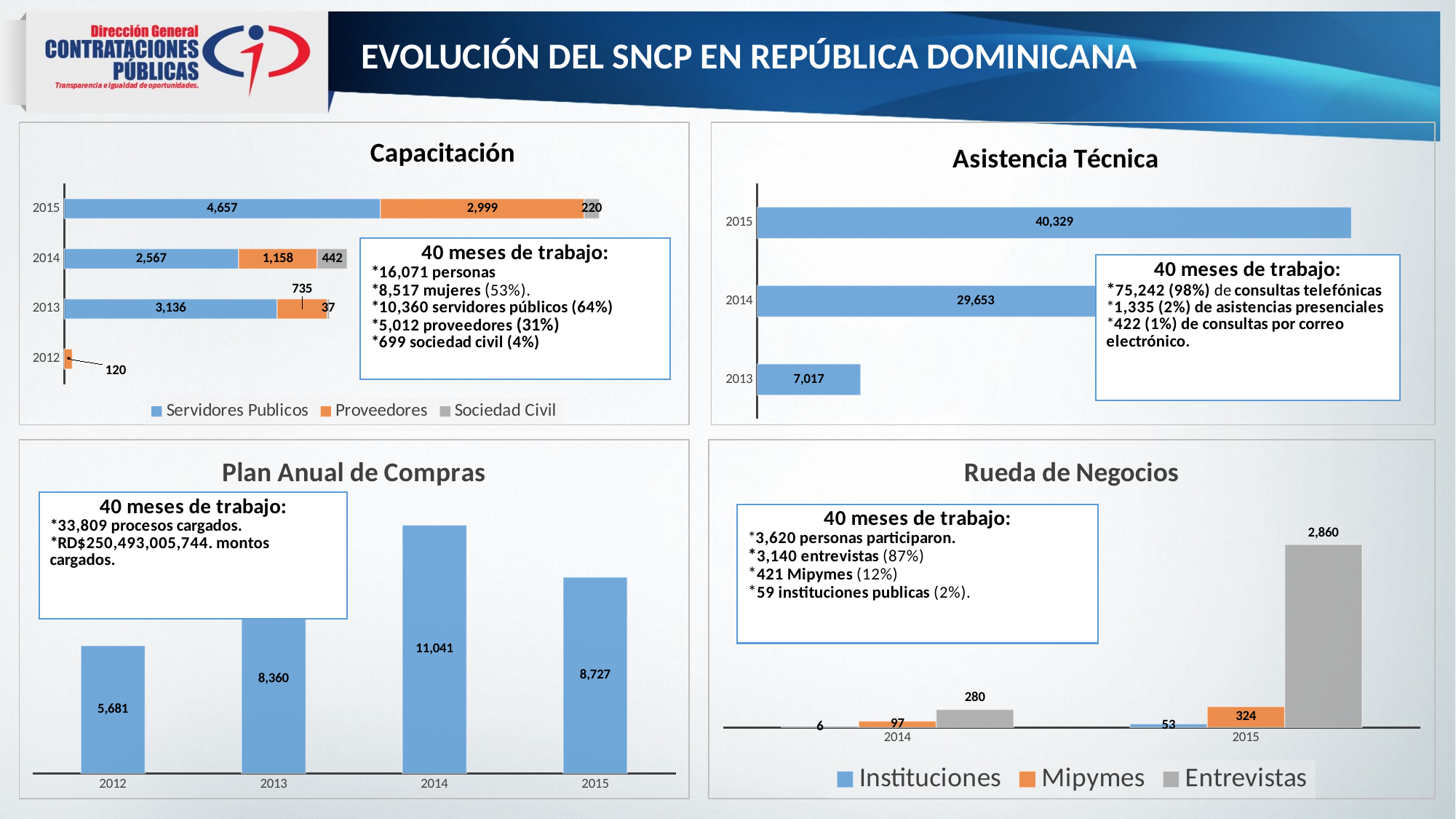
In the Capacitación chart, what is the value for Proveedores in 2014? 1,158 In the Plan Anual de Compras chart, what is the value for 2012? 5,681 In the Asistencia Técnica chart, what is the difference between the 2015 and 2014 values? 10,676 In the Asistencia Técnica chart, what is the value for 2014? 29,653 In the Capacitación chart, what is the total of the stacked bar for 2014? 4,167 In the Asistencia Técnica chart, which year has the lowest value? 2013 In the Capacitación chart, what is the value for Servidores Publicos in 2015? 4,657 In the Rueda de Negocios chart, which is larger: Mipymes in 2014 or Mipymes in 2015? Mipymes in 2015 In the Plan Anual de Compras chart, which year has the highest value? 2014 In the Rueda de Negocios chart, what is the value for Entrevistas in 2015? 2,860 What kind of chart is the Plan Anual de Compras chart? Bar chart How many series does the legend of the Capacitación chart list? 3